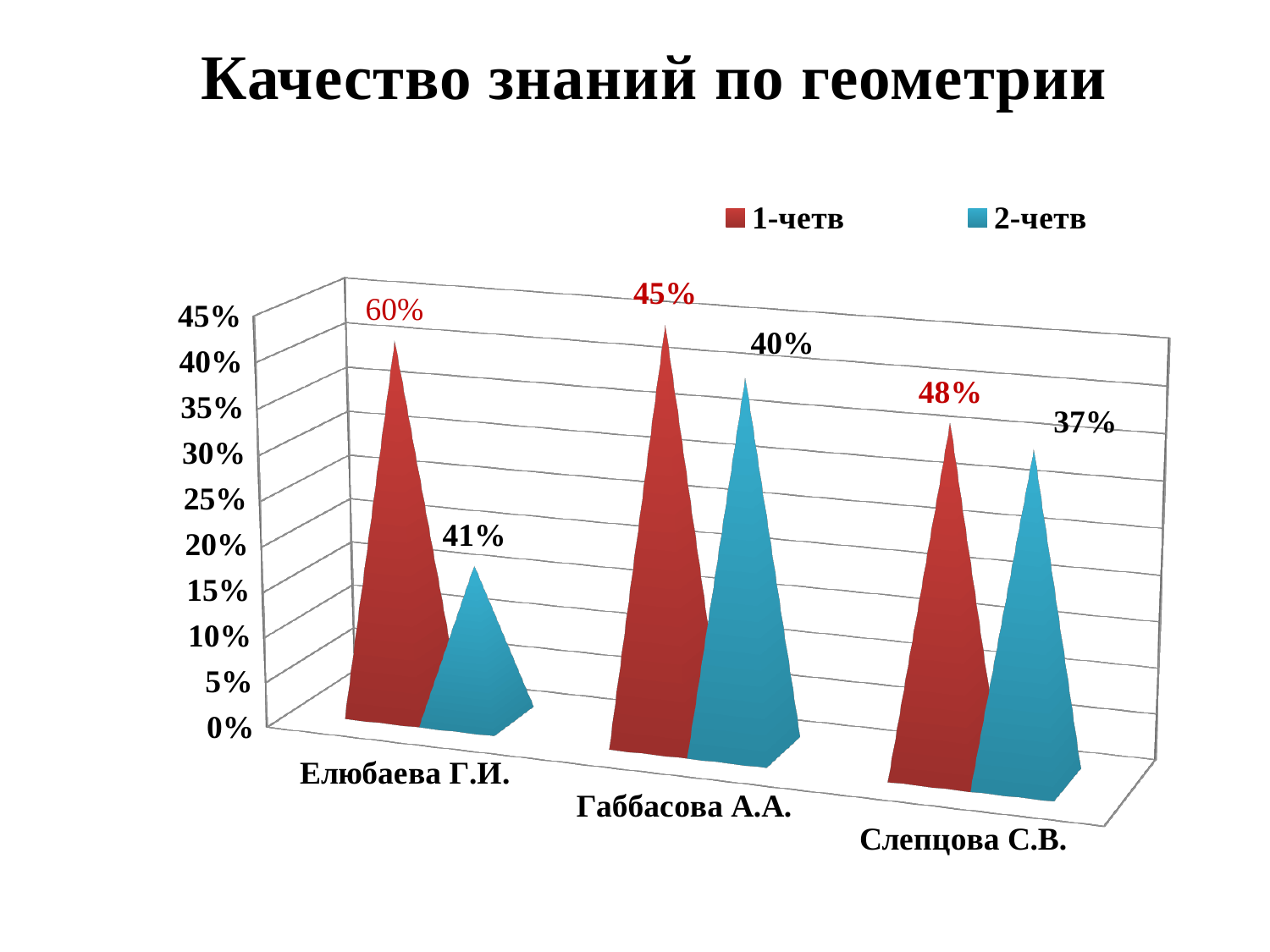
What is the value for Габбасова А.А. in the 2-четв series? 40% What is the value for Габбасова А.А. in the 1-четв series? 45% What is the value for Слепцова С.В. in the 1-четв series? 48% What is the value for Елюбаева Г.И. in the 1-четв series? 60% What is the value for Елюбаева Г.И. in the 2-четв series? 41% How many teachers (categories) are shown on the x axis? 3 For Елюбаева Г.И., which is larger: the 1-четв value or the 2-четв value? 1-четв What is the value for Слепцова С.В. in the 2-четв series? 37% What is the difference between the 1-четв and 2-четв values for Слепцова С.В.? 11% How many series does the legend list? 2 What is the difference between the 1-четв and 2-четв values for Елюбаева Г.И.? 19%